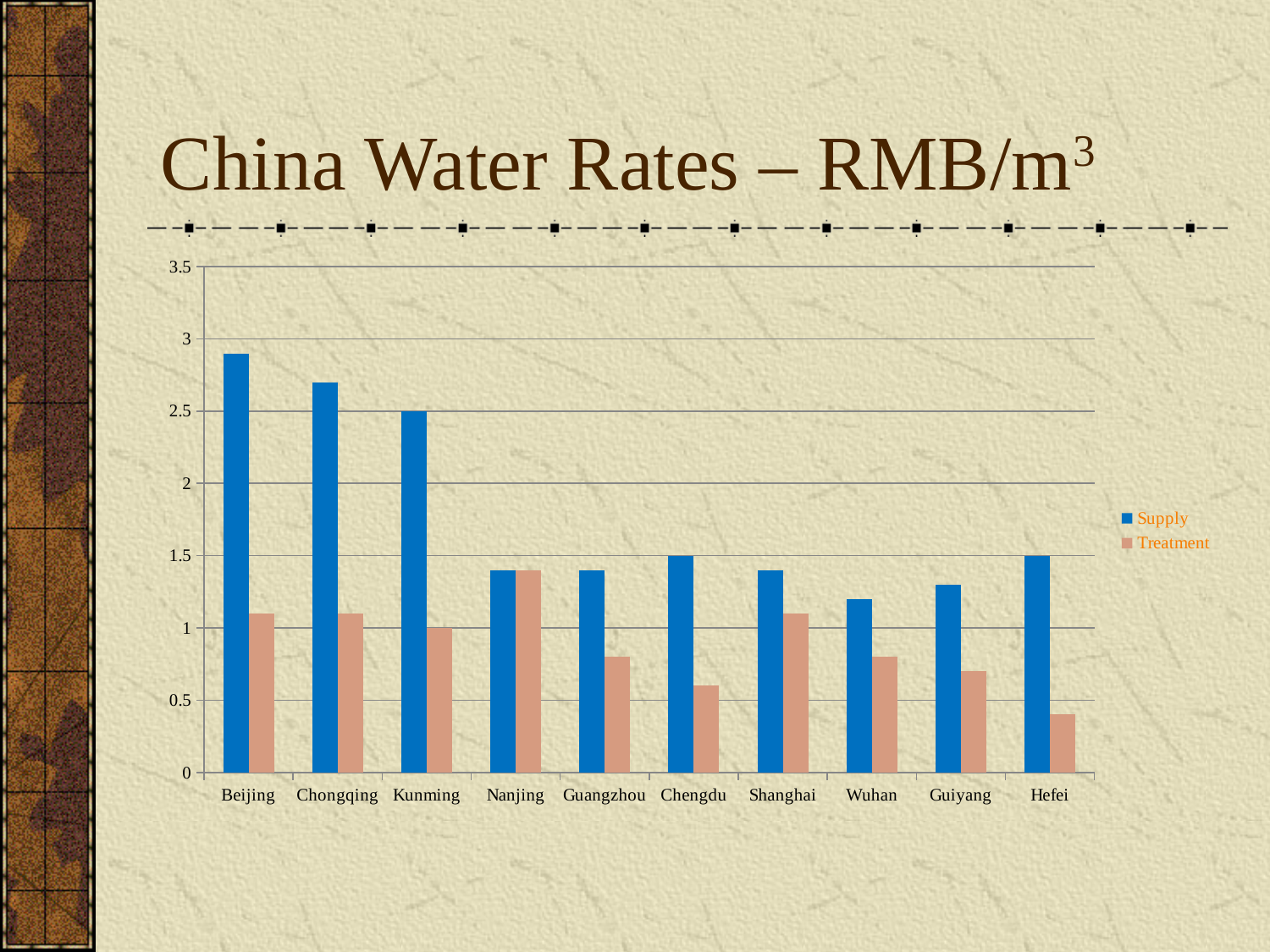
What is the title of the slide containing the chart? China Water Rates – RMB/m³ How many cities are shown on the x axis of the chart? 10 What kind of chart is shown on the slide? bar chart What is the Supply rate for Kunming? 2.5 Is the Supply rate for Beijing greater or less than 2.5? greater Which city has the lowest Treatment rate? Hefei Is the Treatment rate for Hefei greater or less than 0.5? less How many series does the chart's legend list? 2 What are the two series named in the legend? Supply and Treatment Which city has the highest Supply rate? Beijing Which city has the highest Treatment rate? Nanjing Which is larger, the Treatment rate for Nanjing or the Treatment rate for Guangzhou? Nanjing